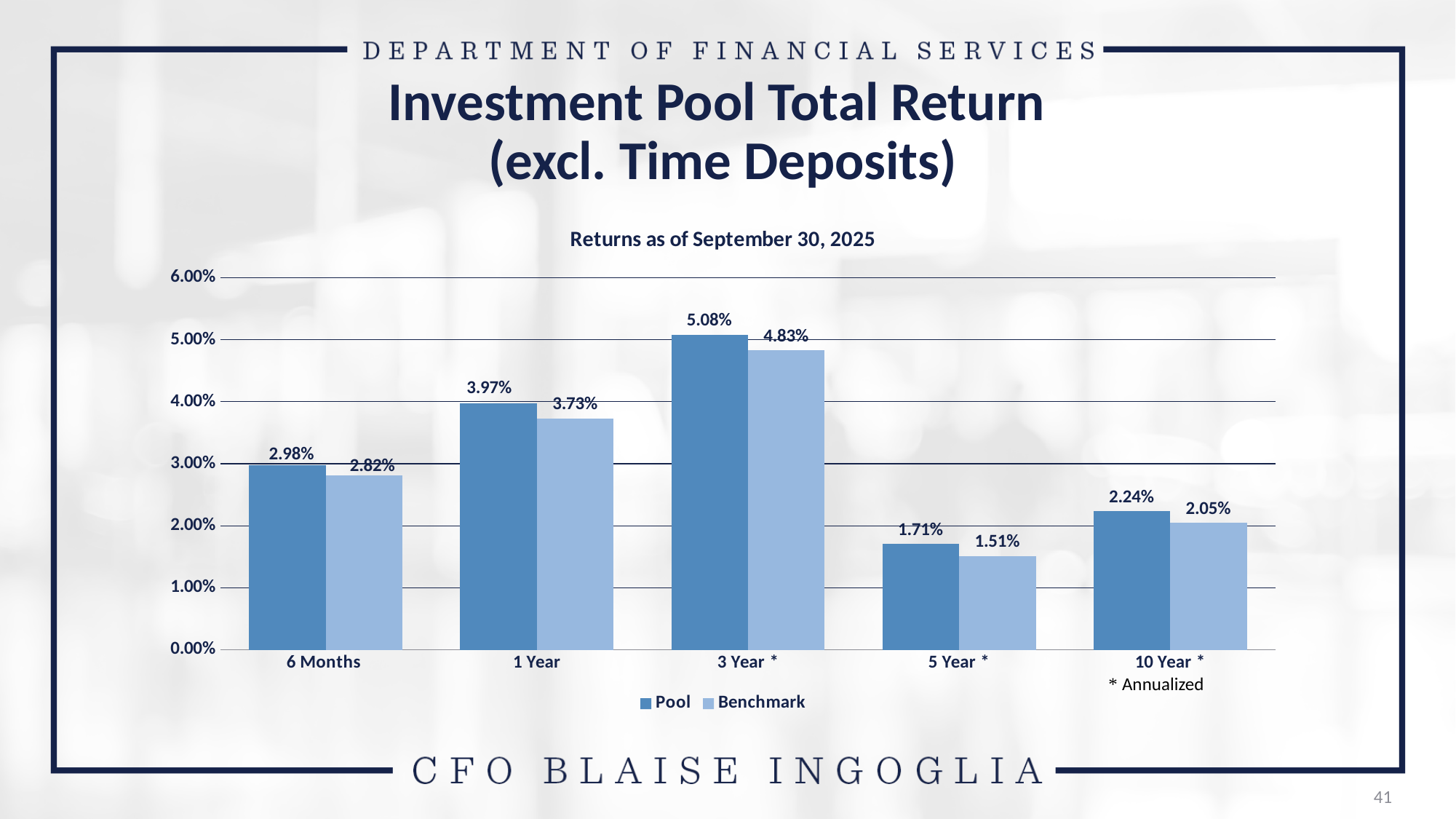
What is the chart's subtitle above the plot area? Returns as of September 30, 2025 What is the Pool return for 10 Year? 2.24% How many series does the legend list? 2 What is the difference between the Pool and Benchmark returns for 1 Year? 0.24% Which period has the highest Pool return? 3 Year How many time periods are shown on the x axis? 5 Is the Benchmark return for 3 Year greater or less than 4.00%? greater What is the Benchmark return for 6 Months? 2.82% Which is larger for 5 Year, the Pool return or the Benchmark return? Pool What is the Pool return for 3 Year? 5.08% Which period has the lowest Benchmark return? 5 Year What kind of chart is shown on the slide? Bar chart